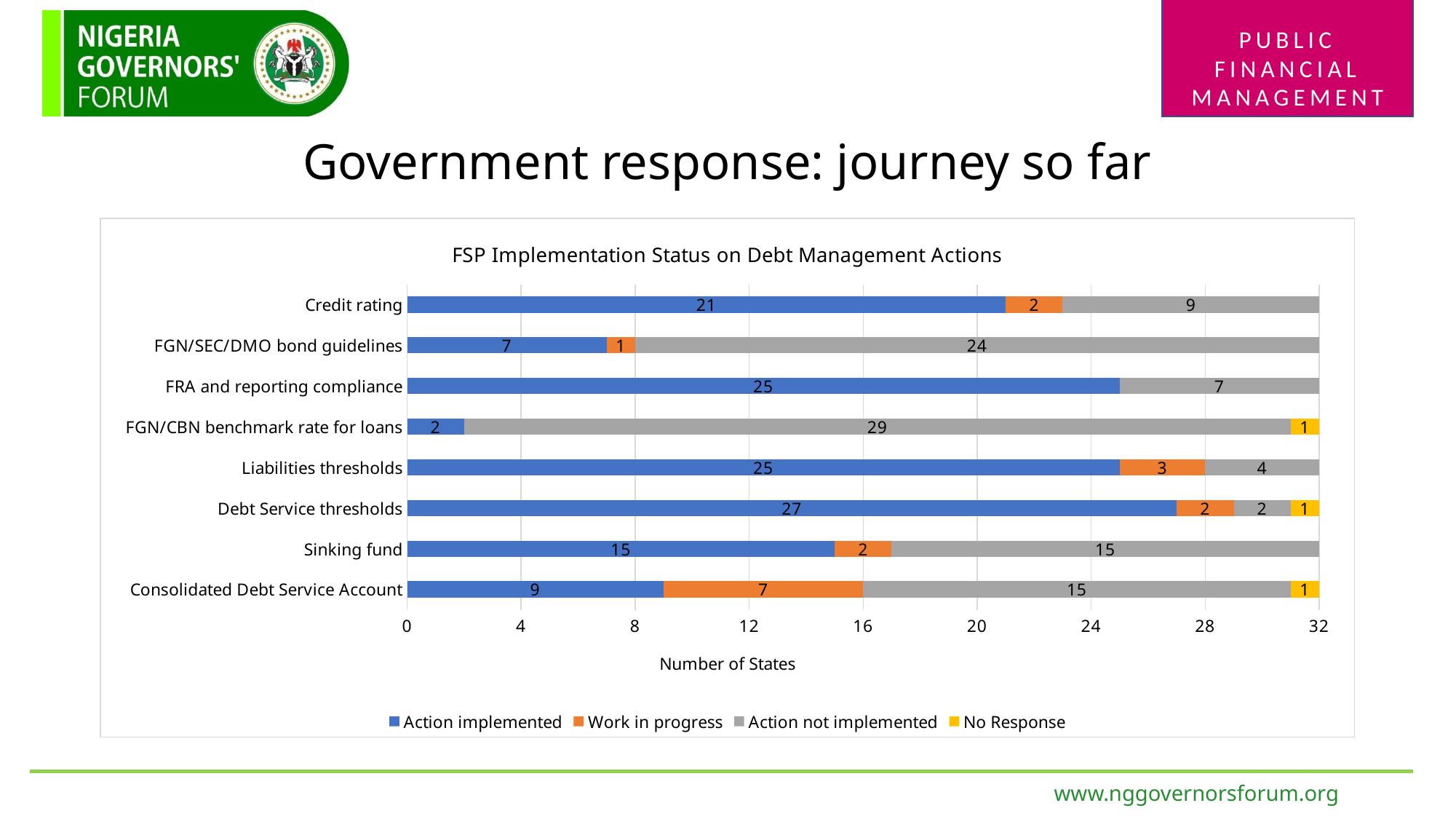
Which category has the highest value for Action implemented? Debt Service thresholds What is the value for Work in progress for Consolidated Debt Service Account? 7 What kind of chart is this? Stacked bar chart How many series does the legend list? 4 What is the value for Action implemented for Credit rating? 21 What is the total of the stacked bar for Liabilities thresholds? 32 What is the value for Action not implemented for FGN/CBN benchmark rate for loans? 29 What is the difference between Action implemented for FRA and reporting compliance and Action implemented for FGN/SEC/DMO bond guidelines? 18 Which is larger: Action not implemented for Sinking fund or Action not implemented for Credit rating? Sinking fund Which category has the lowest value for Action implemented? FGN/CBN benchmark rate for loans How many categories are shown on the y axis? 8 What is the title of the chart? FSP Implementation Status on Debt Management Actions